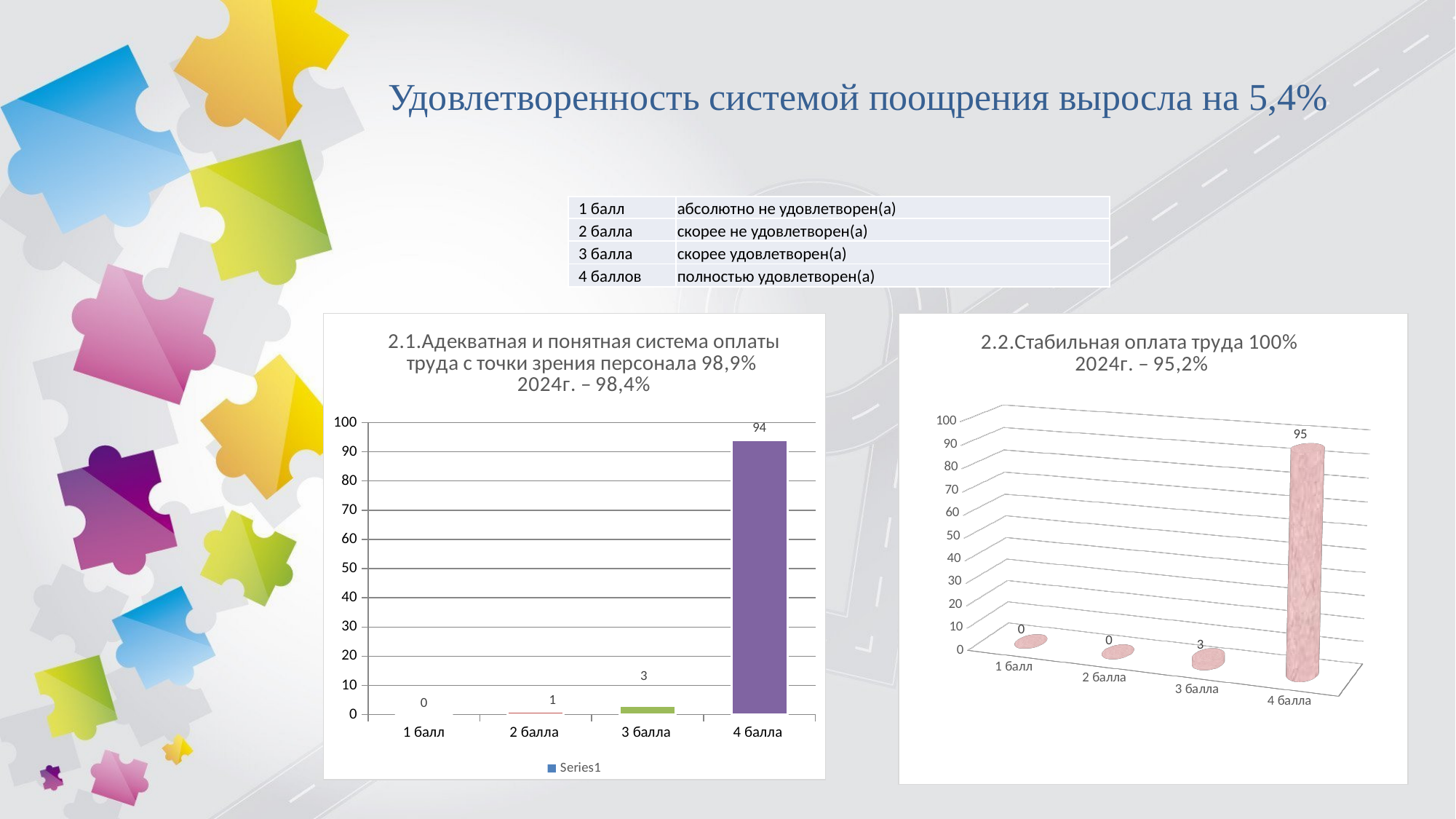
In the right chart (2.2), what is the value for 3 балла? 3 In the left chart (2.1), what is the value for 4 балла? 94 In the left chart (2.1), what is the value for 2 балла? 1 In the right chart (2.2), which category has the highest value? 4 балла How many categories are shown on the x axis of the right chart (2.2)? 4 What series name does the legend of the left chart (2.1) show? Series1 In the right chart (2.2), what is the value for 4 балла? 95 In the left chart (2.1), which category has the highest value? 4 балла What kind of chart is the left chart (2.1)? Bar chart In the left chart (2.1), what is the difference between the values for 4 балла and 3 балла? 91 In the right chart (2.2), what is the difference between the values for 4 балла and 3 балла? 92 In the left chart (2.1), what is the value for 3 балла? 3